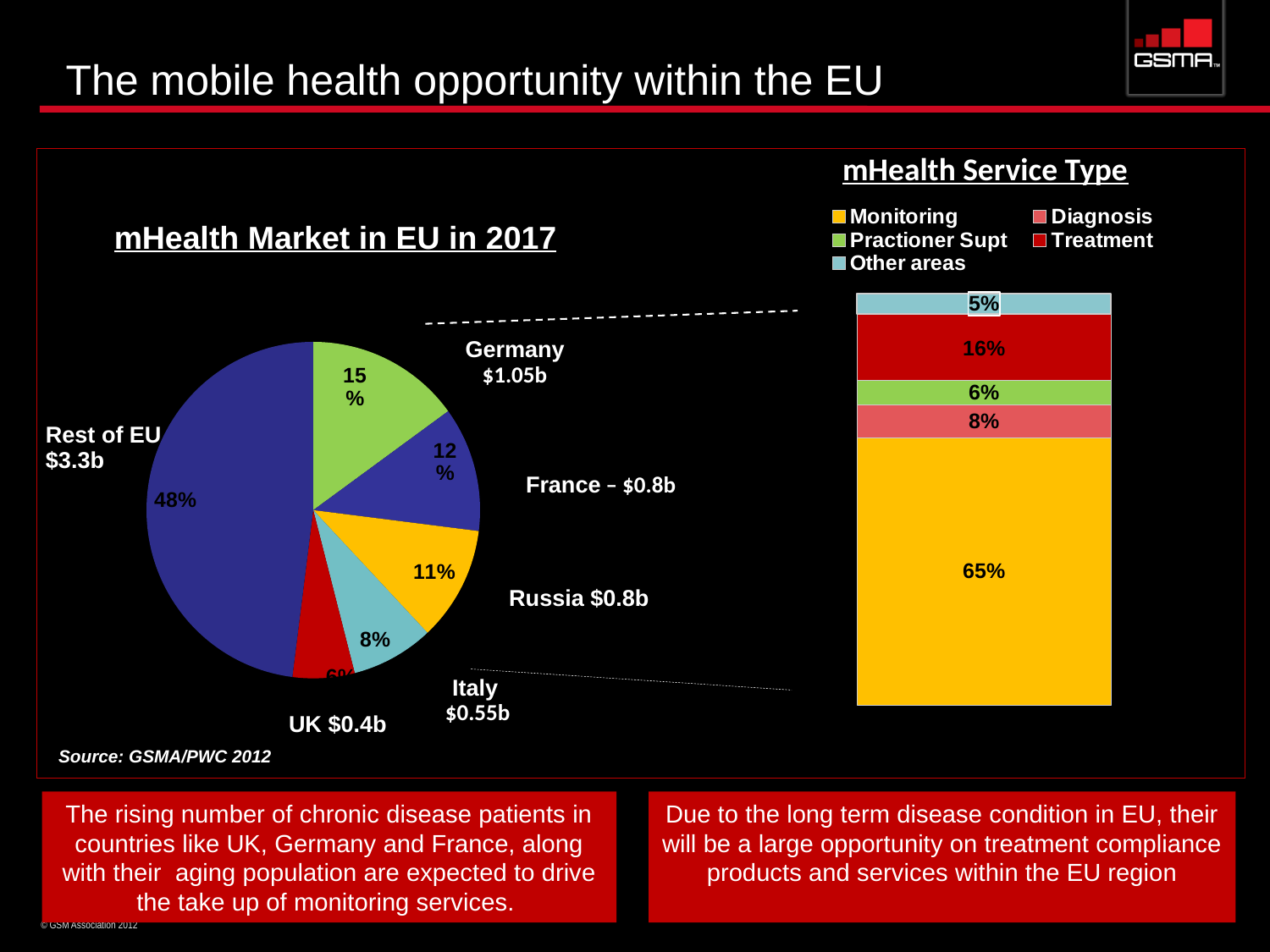
In the mHealth Market in EU in 2017 pie chart, which category has the largest slice? Rest of EU In the mHealth Market in EU in 2017 pie chart, what share does Rest of EU hold? 48% How many slices does the mHealth Market in EU in 2017 pie chart have? 6 What kind of chart is the mHealth Service Type chart? Stacked bar chart What kind of chart is the mHealth Market in EU in 2017 chart? Pie chart In the mHealth Service Type chart, which service type has the smallest segment? Other areas In the mHealth Service Type chart, what percentage is shown for Treatment? 16% In the mHealth Market in EU in 2017 pie chart, which has the larger share, Germany or France? Germany In the mHealth Market in EU in 2017 pie chart, what is the market value shown for Germany? $1.05b In the mHealth Service Type chart, what is the difference between the Treatment and Diagnosis percentages? 8% How many series does the legend of the mHealth Service Type chart list? 5 In the mHealth Service Type chart, what percentage is shown for Monitoring? 65%